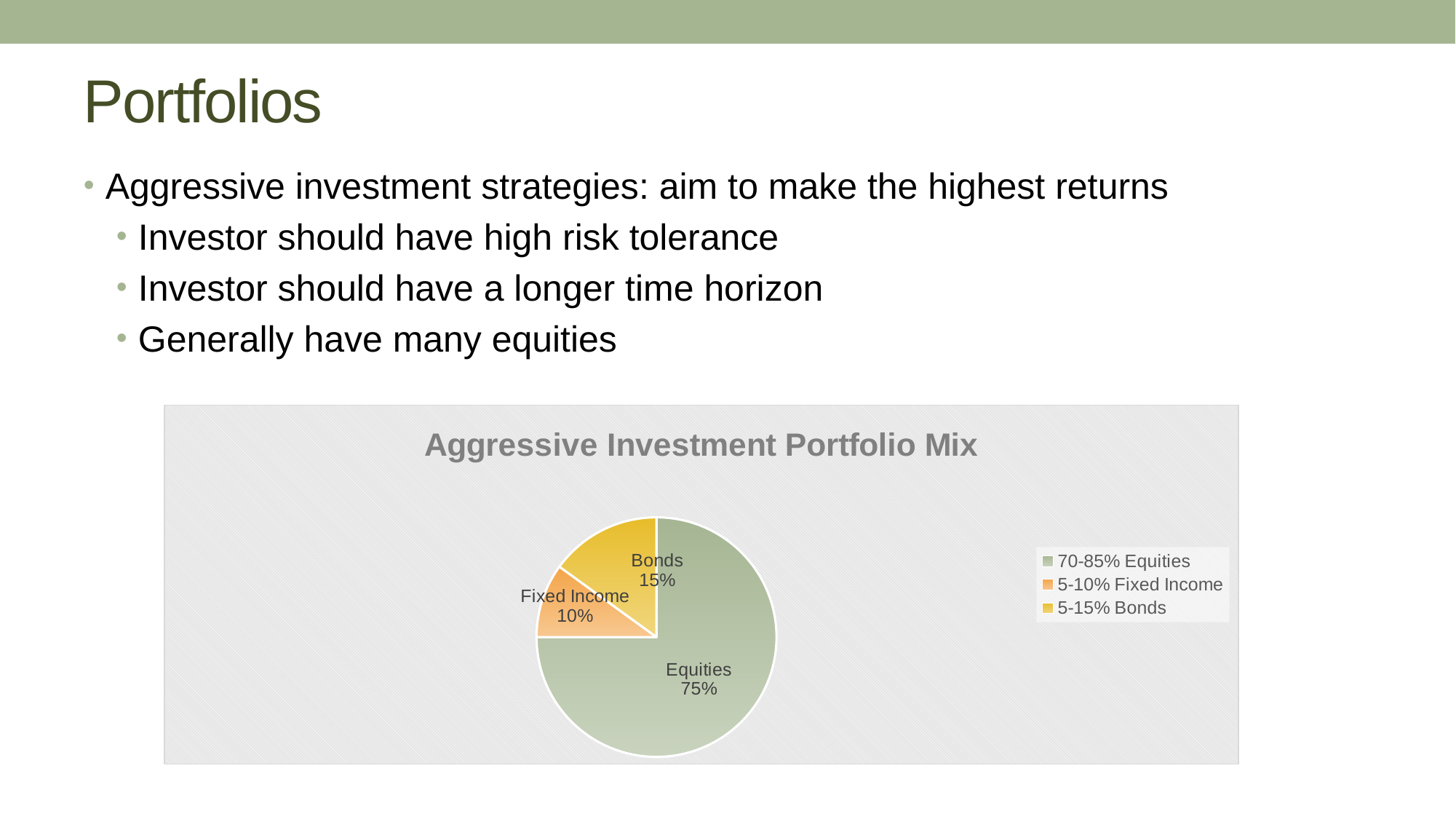
Which is larger, the Bonds slice or the Fixed Income slice? Bonds Which slice of the pie is the smallest? Fixed Income What kind of chart is shown on the slide? pie chart How many slices does the pie chart have? 3 How many entries does the legend list? 3 What is the title of the chart? Aggressive Investment Portfolio Mix Which slice of the pie is the largest? Equities What is the difference in percentage points between the Equities slice and the Bonds slice? 60 What percentage of the portfolio mix is Equities? 75% What range does the legend give for Equities? 70-85% What percentage of the portfolio mix is Bonds? 15% What percentage of the portfolio mix is Fixed Income? 10%